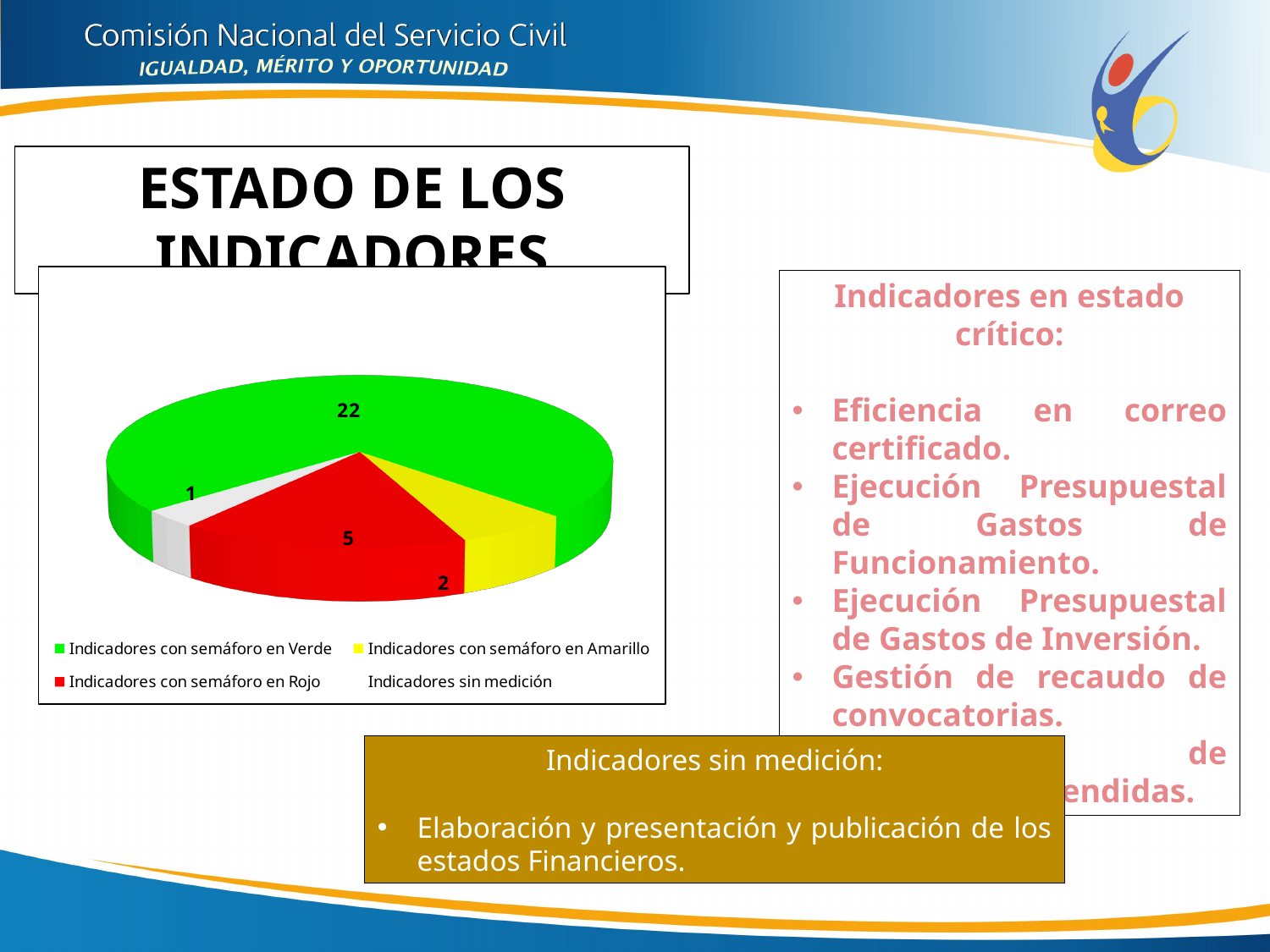
What kind of chart is shown on the slide? pie chart How many indicators have a yellow traffic light (Indicadores con semáforo en Amarillo)? 2 How many indicators are without measurement (Indicadores sin medición)? 1 Which category has the largest slice of the pie? Indicadores con semáforo en Verde What is the total number of indicators represented in the pie chart? 30 Which category has the smallest slice of the pie? Indicadores sin medición How many indicators have a green traffic light (Indicadores con semáforo en Verde)? 22 What is the difference between the number of indicators in green and the number in red? 17 How many indicators have a red traffic light (Indicadores con semáforo en Rojo)? 5 Which is larger: the number of indicators in red or the number in yellow? Indicadores con semáforo en Rojo What colour represents the indicators with a red traffic light in the pie chart? red How many categories does the pie chart show? 4